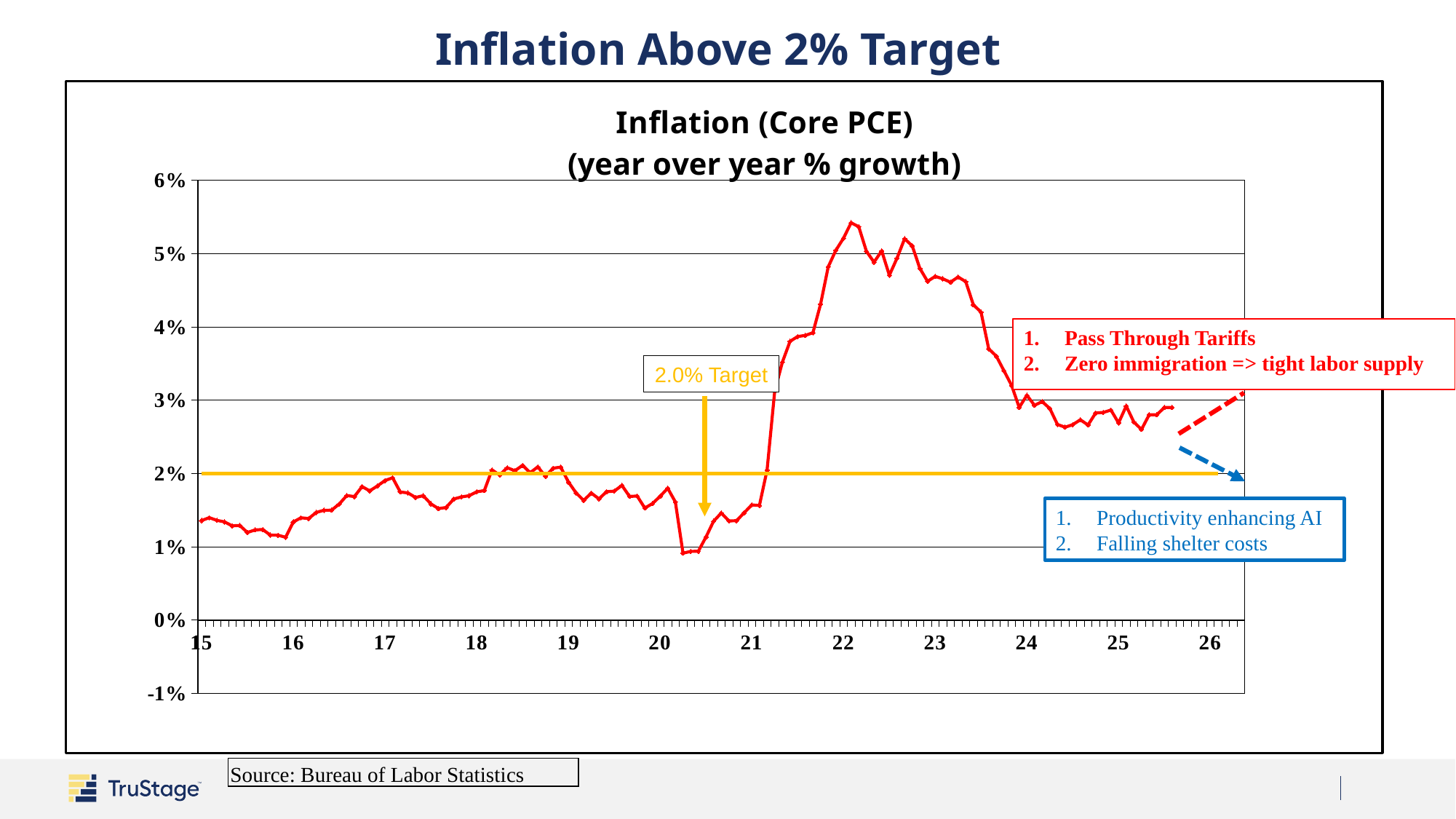
Does the inflation line rise or fall between the x-axis labels 20 and 22? rise In which year labelled on the x axis does the inflation line reach its lowest point? 20 How many year labels are shown on the x axis? 12 Does the inflation line rise or fall between the x-axis labels 22 and 24? fall What value does the horizontal yellow target line mark on the chart? 2.0% Is the inflation value at the end of the plotted line (around 25) greater or less than 2%? greater What is the title of the chart? Inflation (Core PCE) (year over year % growth) Is the lowest value of the inflation line greater or less than 1%? less Is the peak value of the inflation line greater or less than 5%? greater In which year labelled on the x axis does the inflation line reach its highest point? 22 What kind of chart is shown on the slide? line chart